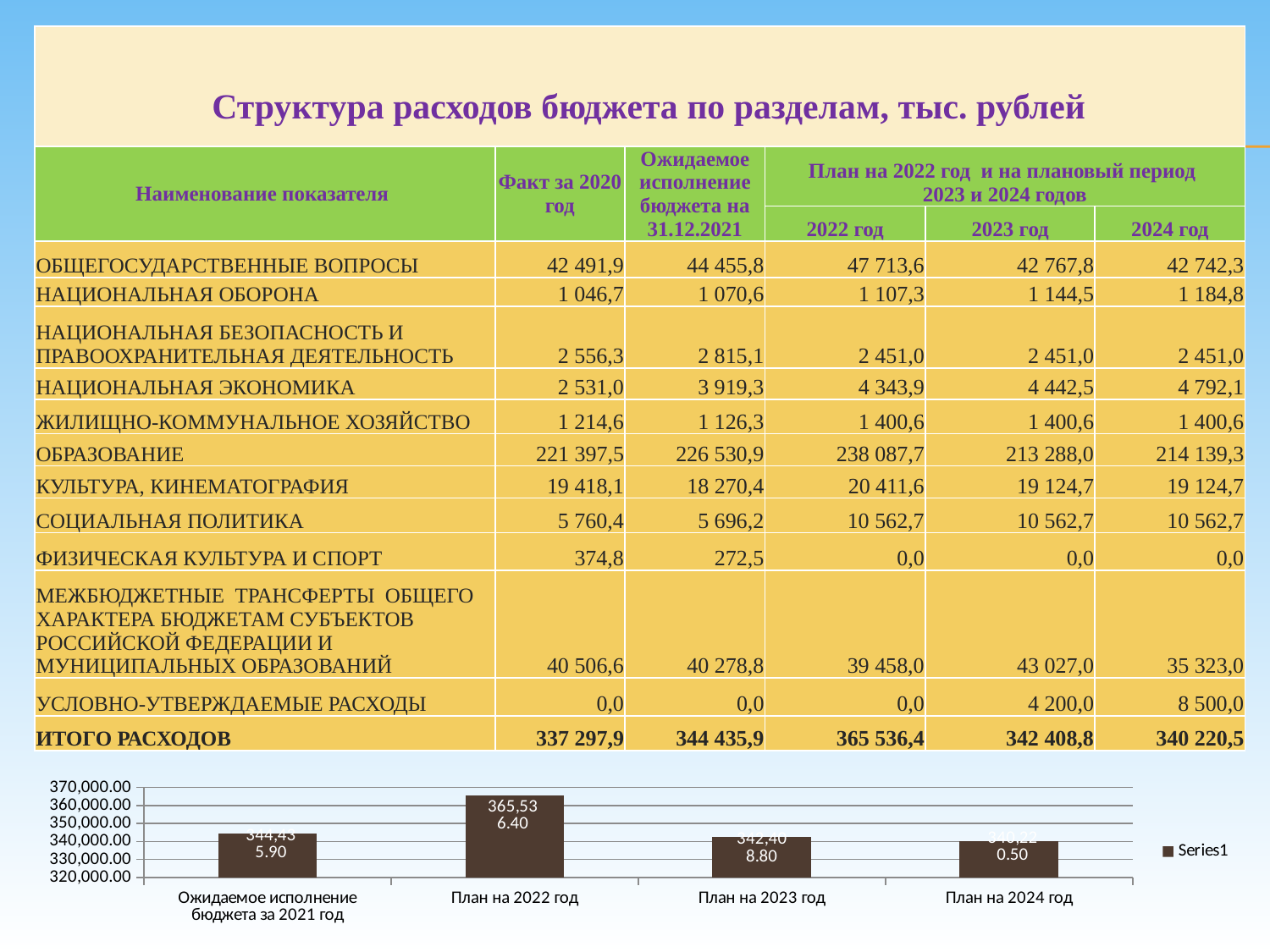
How many series does the legend of the chart list? 1 What value is labelled on the bar for План на 2022 год? 365,536.40 Which category has the highest bar in the chart? План на 2022 год What kind of chart is shown at the bottom of the slide? bar chart Which category has the lowest bar in the chart? План на 2024 год How many bars are plotted in the chart at the bottom of the slide? 4 Is the value for План на 2024 год greater or less than 350,000.00? less What is the lowest value shown on the vertical axis of the chart? 320,000.00 Is the value for План на 2022 год greater or less than 360,000.00? greater Which is larger, the bar for План на 2022 год or the bar for План на 2023 год? План на 2022 год Is the value for Ожидаемое исполнение бюджета за 2021 год greater or less than 340,000.00? greater What is the legend entry shown for the chart? Series1